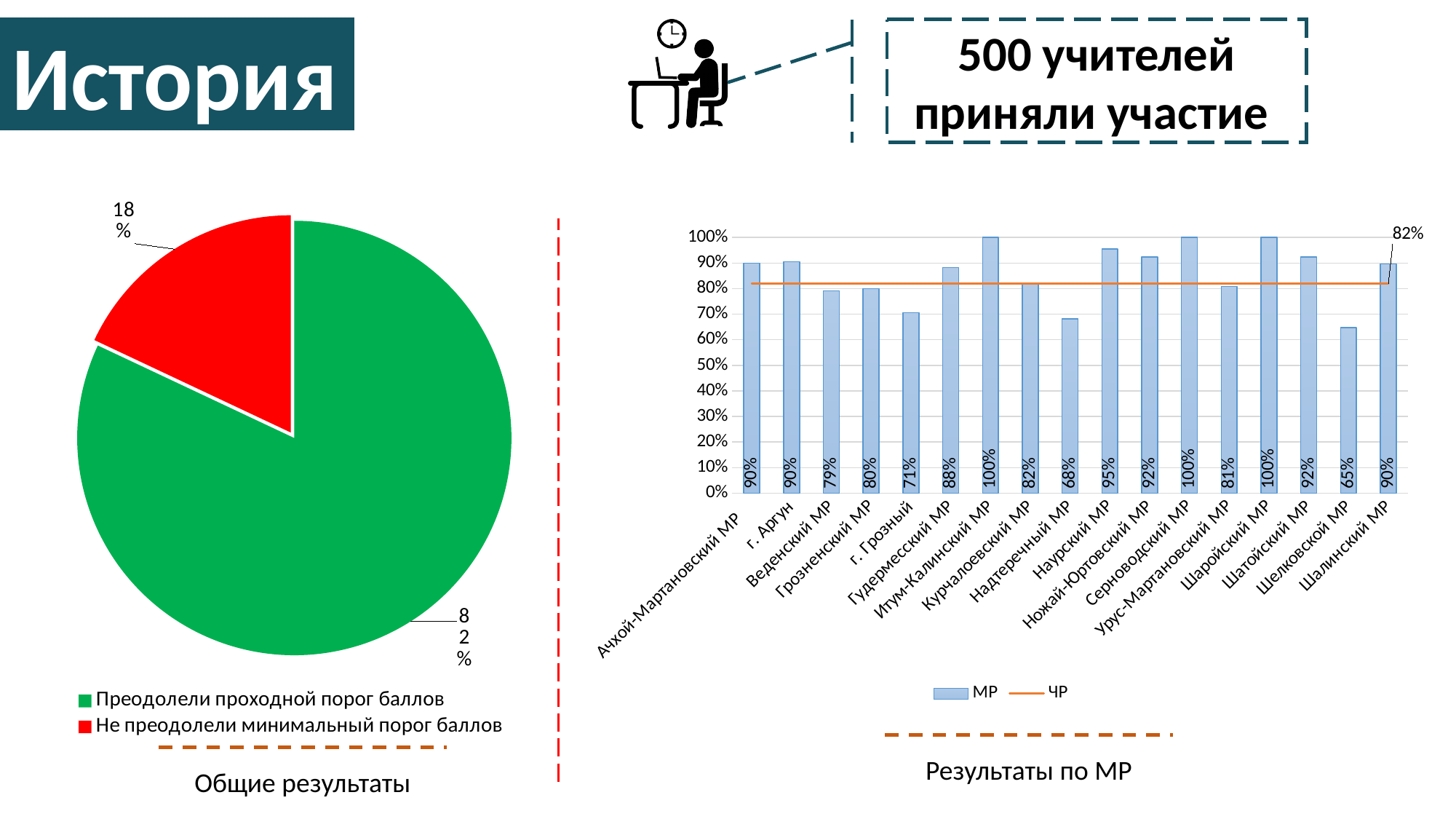
In the bar chart 'Результаты по МР', which is larger: the value for Гудермесский МР or the value for г. Грозный? Гудермесский МР In the bar chart 'Результаты по МР', what is the value for Шелковской МР? 65% What kind of chart is the chart on the left of the slide ('Общие результаты')? Pie chart In the bar chart 'Результаты по МР', what is the difference between the values for Итум-Калинский МР and Надтеречный МР? 32% In the pie chart 'Общие результаты', what share of teachers passed the threshold ('Преодолели проходной порог баллов')? 82% In the pie chart 'Общие результаты', what share is labelled 'Не преодолели минимальный порог баллов'? 18% In the bar chart 'Результаты по МР', how many series does the legend list? 2 In the pie chart 'Общие результаты', which slice is larger: 'Преодолели проходной порог баллов' or 'Не преодолели минимальный порог баллов'? Преодолели проходной порог баллов In the bar chart 'Результаты по МР', what value does the ЧР line show? 82% In the bar chart 'Результаты по МР', which district has the lowest value? Шелковской МР In the bar chart 'Результаты по МР', what is the value for Наурский МР? 95% In the bar chart 'Результаты по МР', how many districts are shown on the x axis? 17